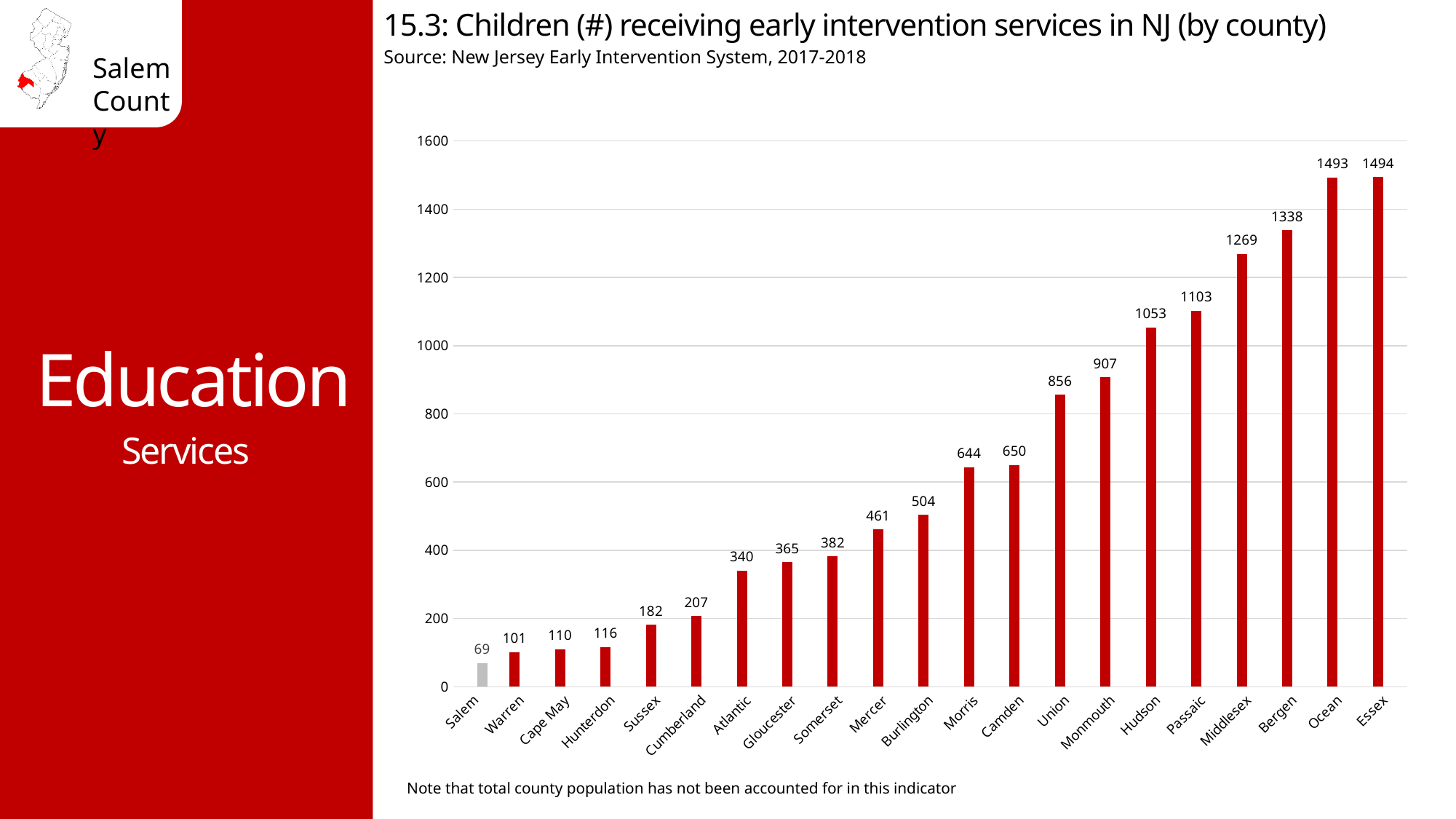
How many counties are shown on the chart? 21 Which county has the lowest number of children receiving early intervention services? Salem What is the difference between the values for Bergen and Middlesex? 69 What is the difference between the values for Warren and Salem? 32 What kind of chart is shown on the slide? Bar chart Which county has the highest number of children receiving early intervention services? Essex Do the values rise or fall moving from left to right along the x axis? Rise What is the value shown for Middlesex? 1269 Which county has a larger value, Hudson or Union? Hudson Is the value for Monmouth greater or less than 1000? less What is the value shown for Mercer? 461 How many children received early intervention services in Salem County? 69